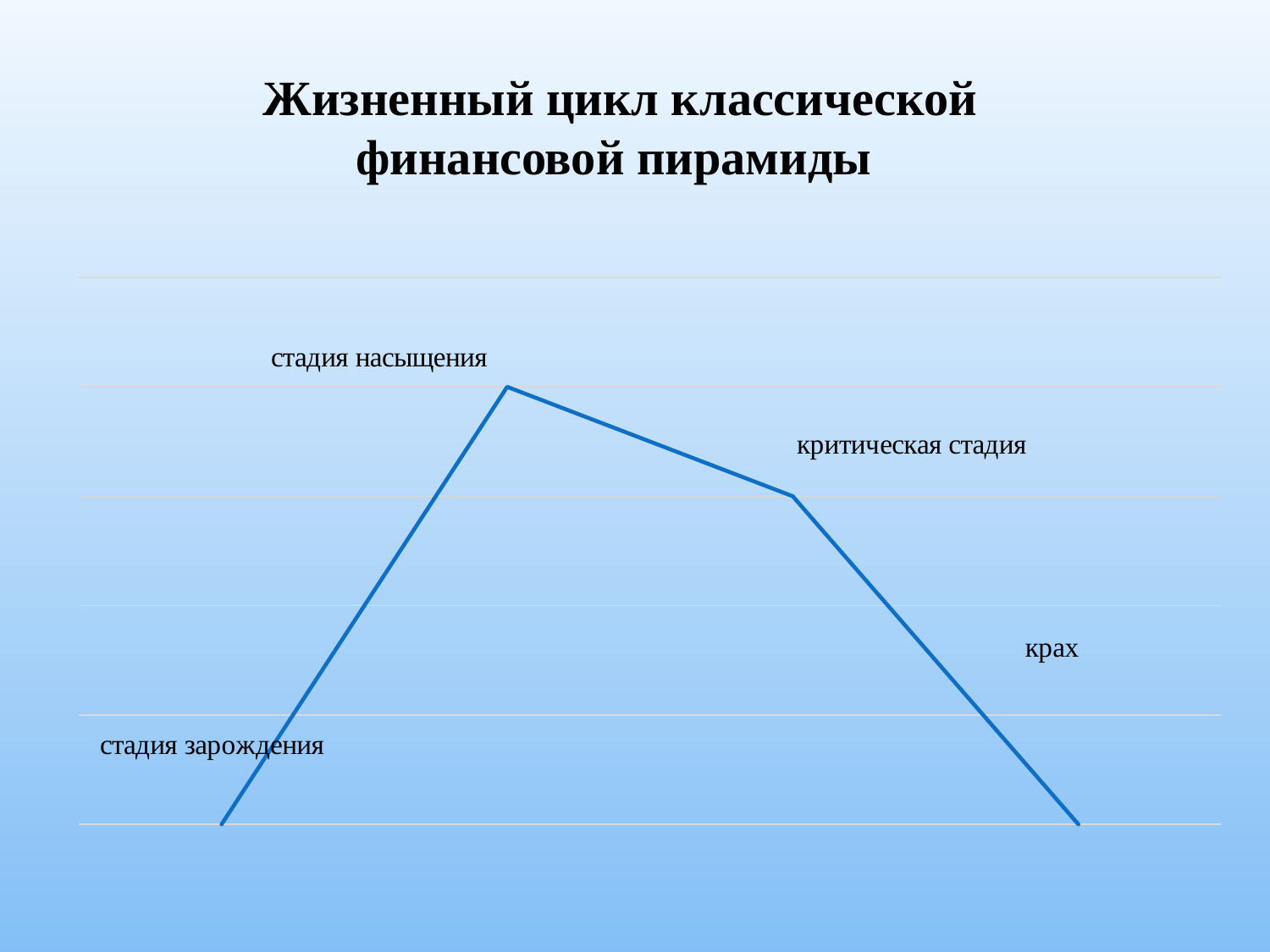
What is the overall shape of the line from left to right? rises then falls Does the line rise or fall between критическая стадия and крах? fall Which is higher on the line: стадия насыщения or критическая стадия? стадия насыщения Which is higher on the line: критическая стадия or крах? критическая стадия How many labeled stages (points) are marked on the line? 4 What kind of chart is shown on the slide? line chart What is the title of the chart on the slide? Жизненный цикл классической финансовой пирамиды Which labeled stage is at the highest point of the line? стадия насыщения Which stage label appears first (leftmost) along the line? стадия зарождения Which is higher on the line: стадия зарождения or критическая стадия? критическая стадия Does the line rise or fall between стадия зарождения and стадия насыщения? rise